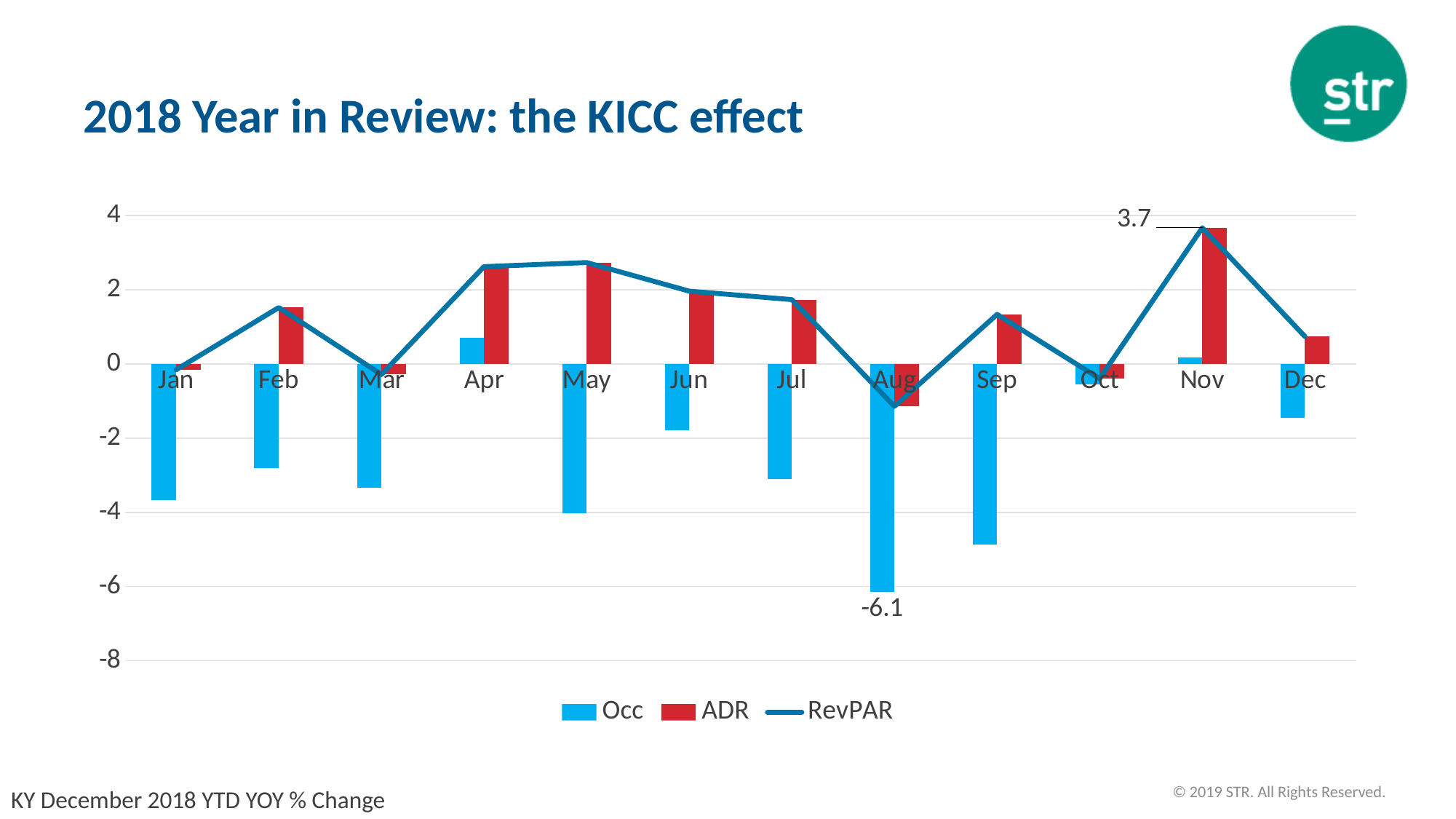
In which month is the Occ value lowest? Aug How many series does the legend list? 3 What kind of chart is shown on the slide? A combined bar and line chart How many months are shown along the x axis? 12 Does the RevPAR line rise or fall from May to Aug? fall Is the RevPAR value for Nov greater or less than 2? greater Is the ADR value for Apr greater or less than 2? greater Is the Occ value for May greater or less than -2? less In which month is the ADR value highest? Nov What is the Occ value for Aug? -6.1 What are the three entries in the legend? Occ, ADR, RevPAR Which is larger, the Occ value for Jan or the Occ value for Feb? Feb